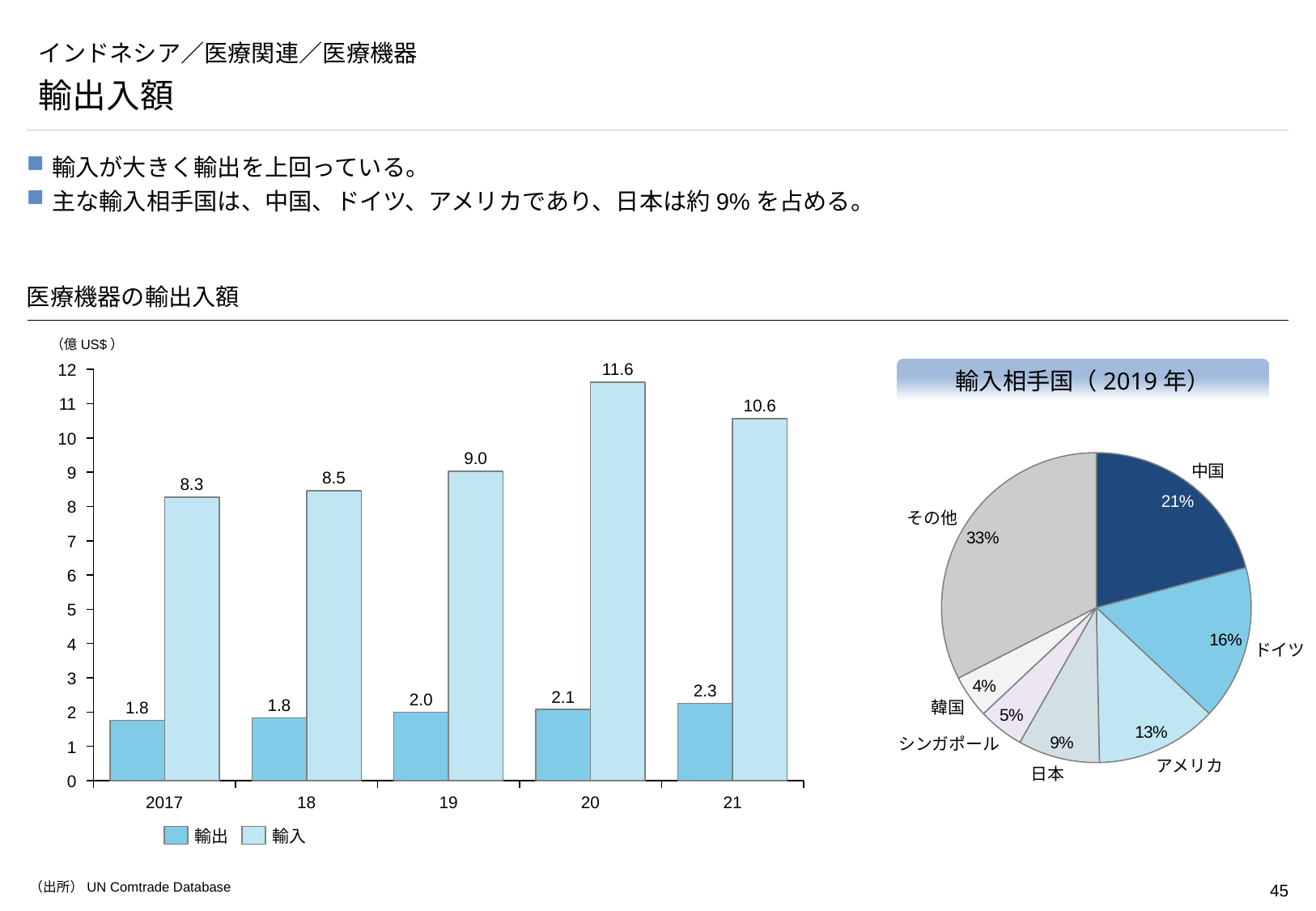
In the bar chart 医療機器の輸出入額, what is the value of 輸入 for 2017? 8.3 In the pie chart 輸入相手国（2019年）, which named country has the smallest share? 韓国 What kind of chart is 輸入相手国（2019年）? pie chart In the bar chart 医療機器の輸出入額, what is the value of 輸出 for 21? 2.3 In the bar chart 医療機器の輸出入額, how many series does the legend list? 2 In the pie chart 輸入相手国（2019年）, which is larger, ドイツ or アメリカ? ドイツ In the bar chart 医療機器の輸出入額, what is the difference between 輸入 and 輸出 in 20? 9.5 In the bar chart 医療機器の輸出入額, does the 輸出 value rise or fall from 2017 to 21? rise In the bar chart 医療機器の輸出入額, is the 輸入 value for 19 greater or less than 8? greater In the bar chart 医療機器の輸出入額, how many years are shown on the x axis? 5 In the pie chart 輸入相手国（2019年）, what share does 中国 have? 21% In the bar chart 医療機器の輸出入額, which year has the highest 輸入 value? 20